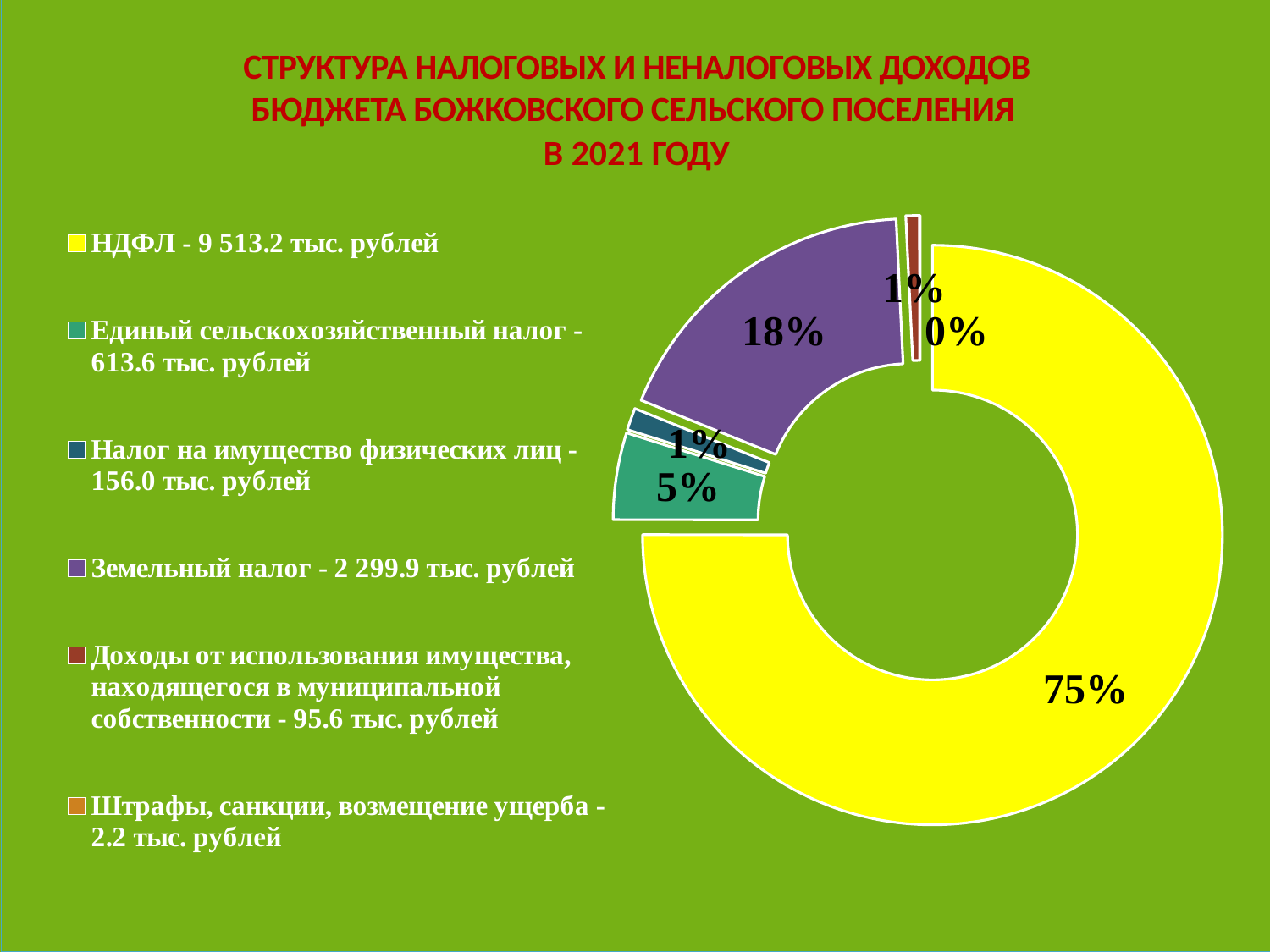
What share of the chart does Штрафы, санкции, возмещение ущерба account for? 0% Which category has the smallest share of the chart? Штрафы, санкции, возмещение ущерба How many categories does the legend of the chart list? 6 What is the difference in percentage points between the share of НДФЛ and the share of Земельный налог? 57 percentage points Which category has the largest share of the chart? НДФЛ What kind of chart is shown on the slide? Doughnut (pie) chart What share of the chart does НДФЛ account for? 75% What share of the chart does Земельный налог account for? 18% What colour is the НДФЛ segment of the chart? Yellow Which is larger: the share of Земельный налог or the share of Единый сельскохозяйственный налог? Земельный налог According to the legend, what is the amount for Земельный налог? 2 299.9 тыс. рублей